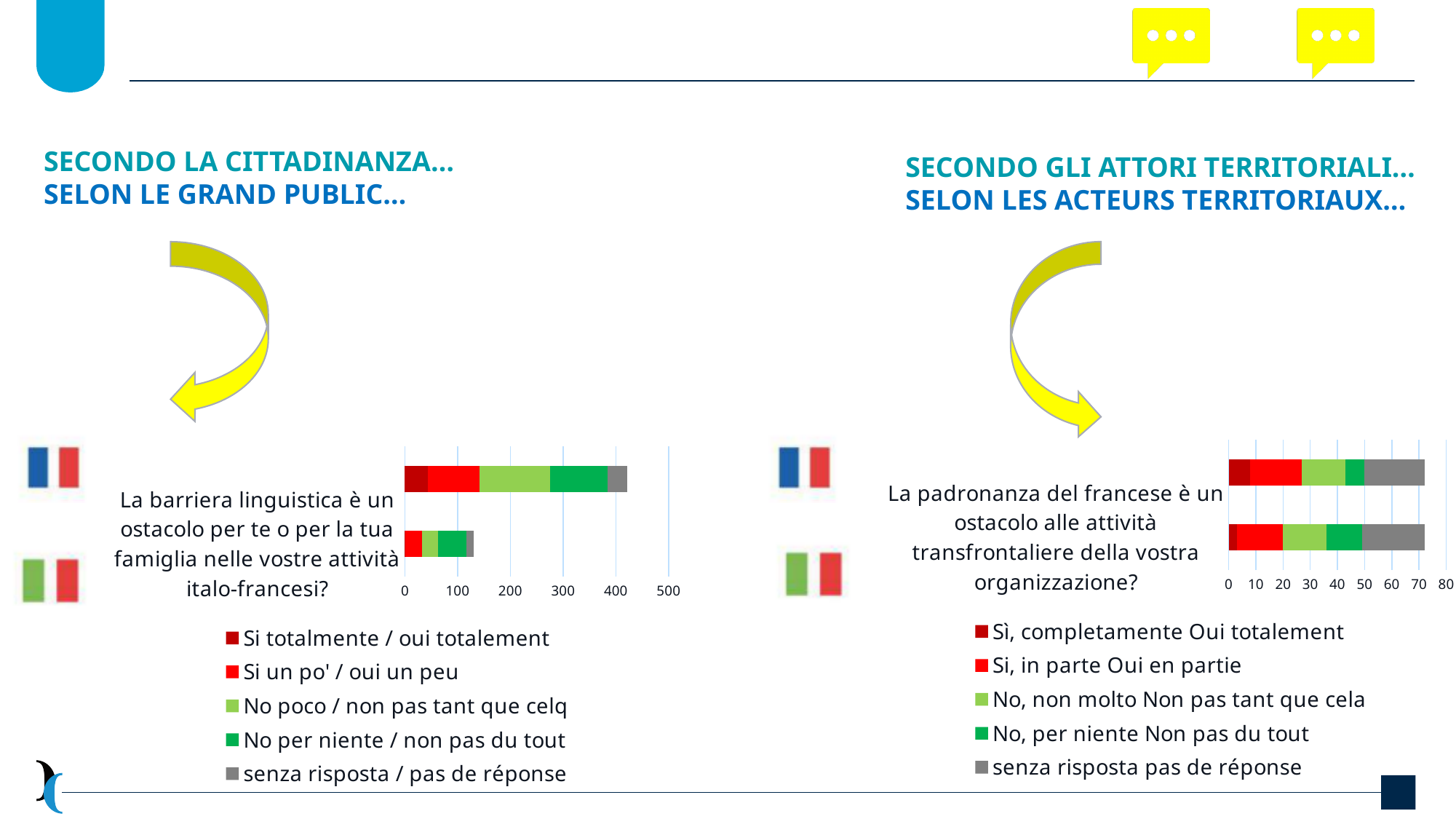
In the left chart ('La barriera linguistica...'), how many bars are plotted? 2 What kind of chart is shown on the right side of the slide, next to the question 'La padronanza del francese è un ostacolo...'? stacked bar chart In the right chart ('La padronanza del francese...'), is the total length of the top bar greater or less than 60? greater In the right chart ('La padronanza del francese...'), how many bars are plotted? 2 In the left chart ('La barriera linguistica...'), which legend entry is shown in grey? senza risposta / pas de réponse In the right chart ('La padronanza del francese...'), what is the highest value shown on the x axis? 80 In the left chart ('La barriera linguistica...'), which bar is longer in total, the top bar or the bottom bar? the top bar In the left chart ('La barriera linguistica...'), is the total length of the bottom bar greater or less than 200? less In the left chart ('La barriera linguistica...'), how many series does the legend list? 5 In the right chart ('La padronanza del francese...'), how many series does the legend list? 5 What kind of chart is shown on the left side of the slide, next to the question 'La barriera linguistica è un ostacolo...'? stacked bar chart In the left chart ('La barriera linguistica...'), is the total length of the top bar greater or less than 400? greater